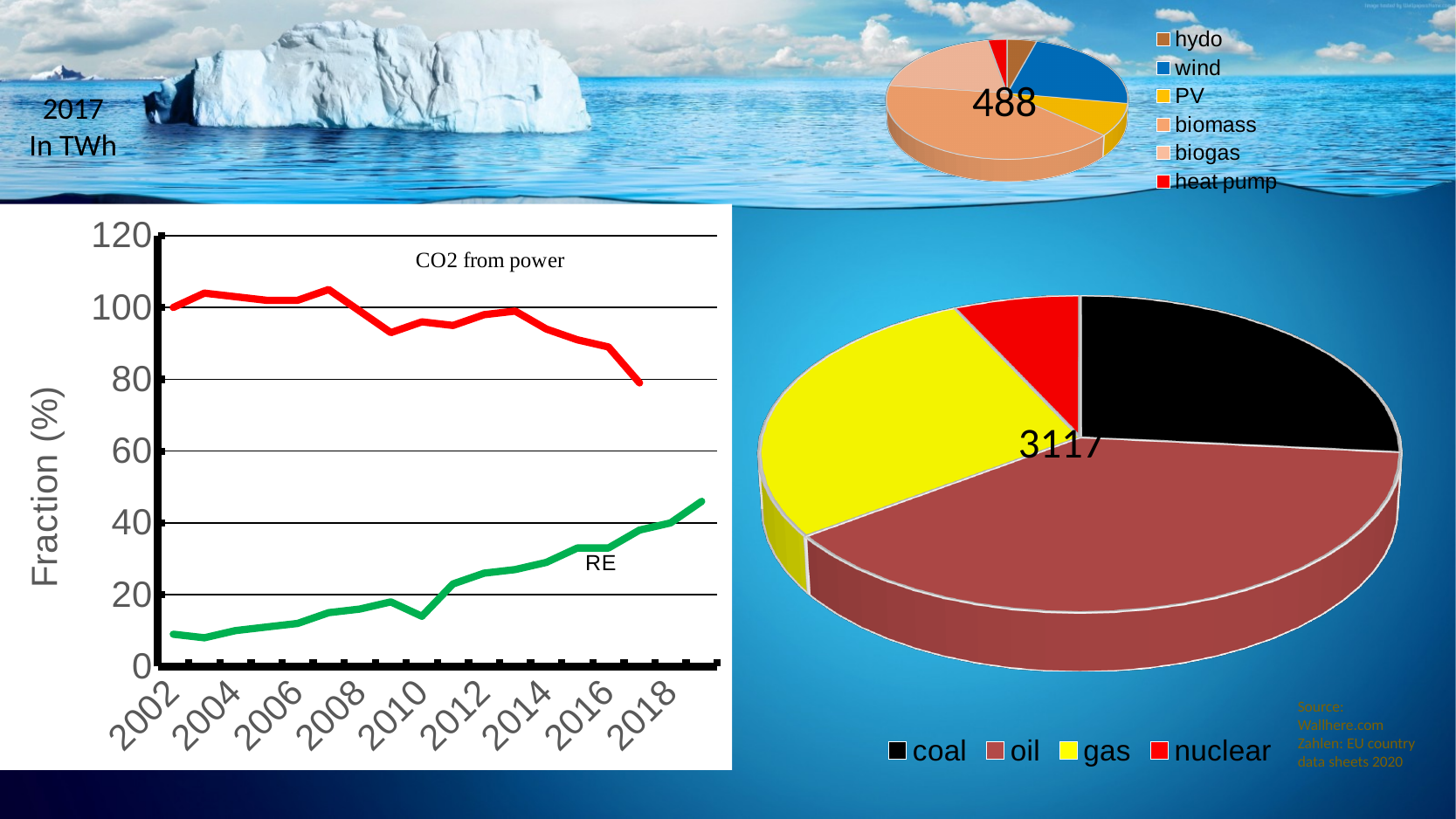
In the small pie chart at the top right, which slice is larger, wind or PV? wind What kind of chart is the chart at the bottom left showing Fraction (%) over years? line chart In the large pie chart at the bottom right, which category has the smallest slice? nuclear How many entries does the legend of the small pie chart at the top right list? 6 In the line chart at the bottom left, does the CO2 from power series rise or fall overall from 2002 to 2017? fall In the line chart at the bottom left, is the value for RE in 2002 greater or less than 20? less How many entries does the legend of the large pie chart at the bottom right list? 4 What number is printed in the centre of the small pie chart at the top right? 488 What number is printed in the centre of the large pie chart at the bottom right? 3117 In the small pie chart at the top right, which category has the largest slice? biomass In the large pie chart at the bottom right, which category has the largest slice? oil In the line chart at the bottom left, does the RE series rise or fall from 2002 to 2018? rise